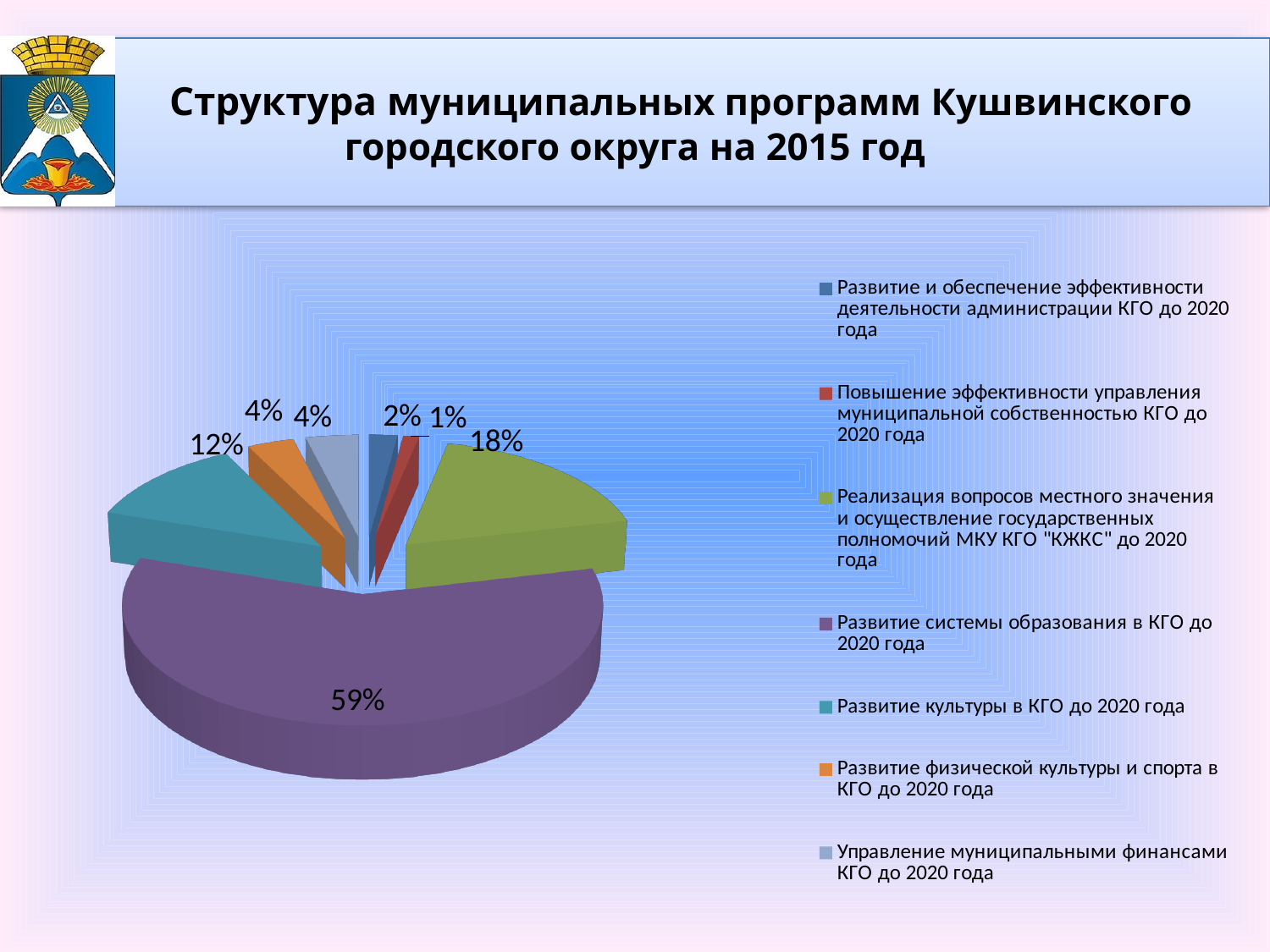
What share of the pie does "Реализация вопросов местного значения и осуществление государственных полномочий МКУ КГО "КЖКС" до 2020 года" have? 18% How many slices does the pie chart have? 7 What share of the pie does "Развитие и обеспечение эффективности деятельности администрации КГО до 2020 года" have? 2% What is the difference in percentage points between the share for "Развитие системы образования в КГО до 2020 года" and the share for "Реализация вопросов местного значения и осуществление государственных полномочий МКУ КГО "КЖКС" до 2020 года"? 41 Which program has the smallest share of the pie? Повышение эффективности управления муниципальной собственностью КГО до 2020 года What share of the pie does "Развитие культуры в КГО до 2020 года" have? 12% Which has the larger share: "Развитие культуры в КГО до 2020 года" or "Развитие физической культуры и спорта в КГО до 2020 года"? Развитие культуры в КГО до 2020 года What type of chart is shown on the slide? Pie chart Which program has the largest share of the pie? Развитие системы образования в КГО до 2020 года What is the title of the slide containing the pie chart? Структура муниципальных программ Кушвинского городского округа на 2015 год